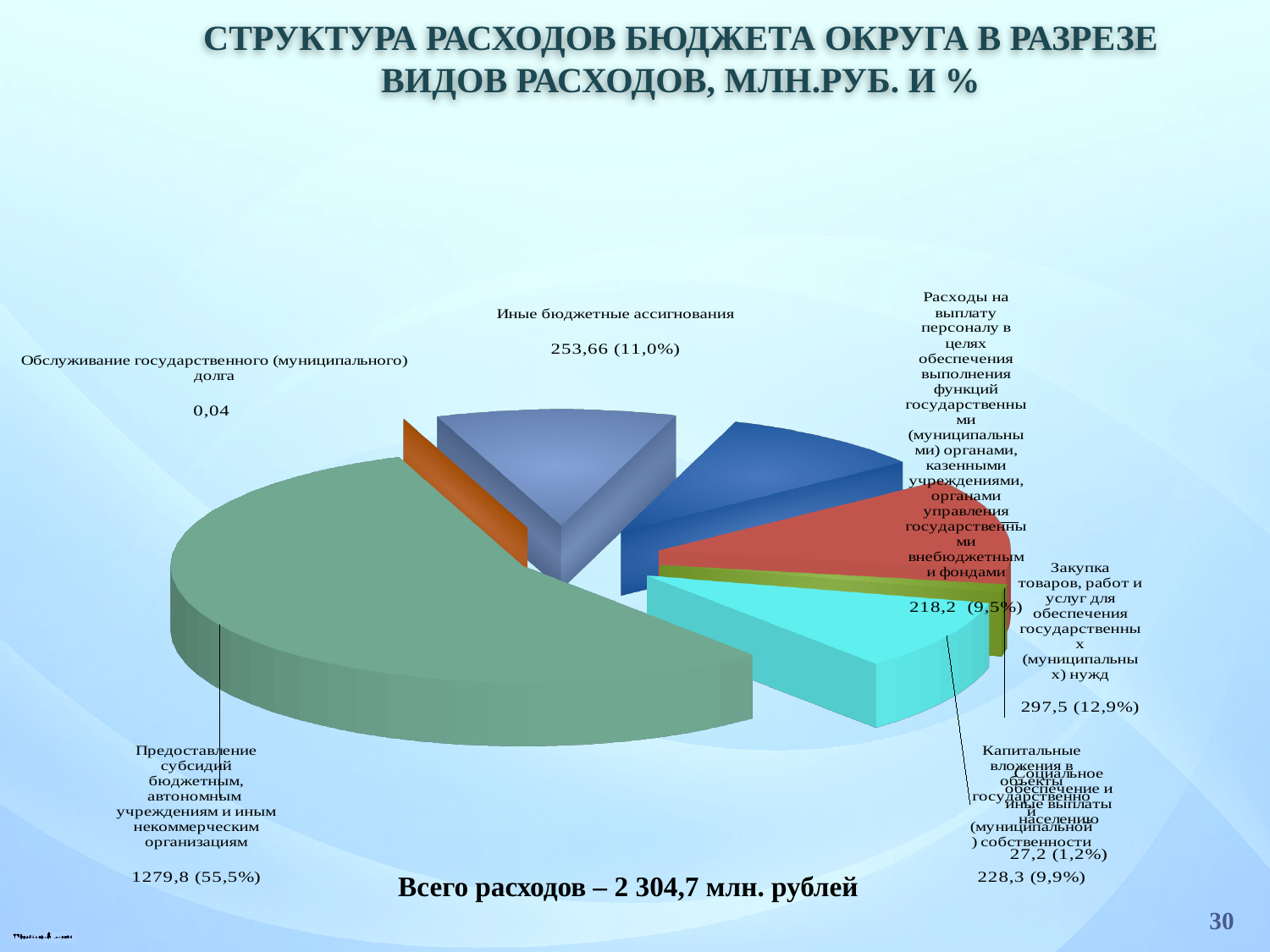
Which is larger: "Закупка товаров, работ и услуг" or "Капитальные вложения в объекты государственной (муниципальной) собственности"? Закупка товаров, работ и услуг What total expenditure is stated below the chart? 2 304,7 млн. рублей What value is shown for "Иные бюджетные ассигнования"? 253,66 (11,0%) Which category has the largest slice of the pie? Предоставление субсидий бюджетным, автономным учреждениям и иным некоммерческим организациям What is the difference between the values for "Закупка товаров, работ и услуг" (297,5) and "Иные бюджетные ассигнования" (253,66)? 43,84 Which category has the smallest value in the pie? Обслуживание государственного (муниципального) долга How many slices does the pie chart have? 7 What kind of chart is shown on the slide? pie chart What value is shown for "Обслуживание государственного (муниципального) долга"? 0,04 What value is shown for "Предоставление субсидий бюджетным, автономным учреждениям и иным некоммерческим организациям"? 1279,8 (55,5%) What value is shown for "Закупка товаров, работ и услуг для обеспечения государственных (муниципальных) нужд"? 297,5 (12,9%) What share of the pie does "Расходы на выплату персоналу" represent? 9,5%